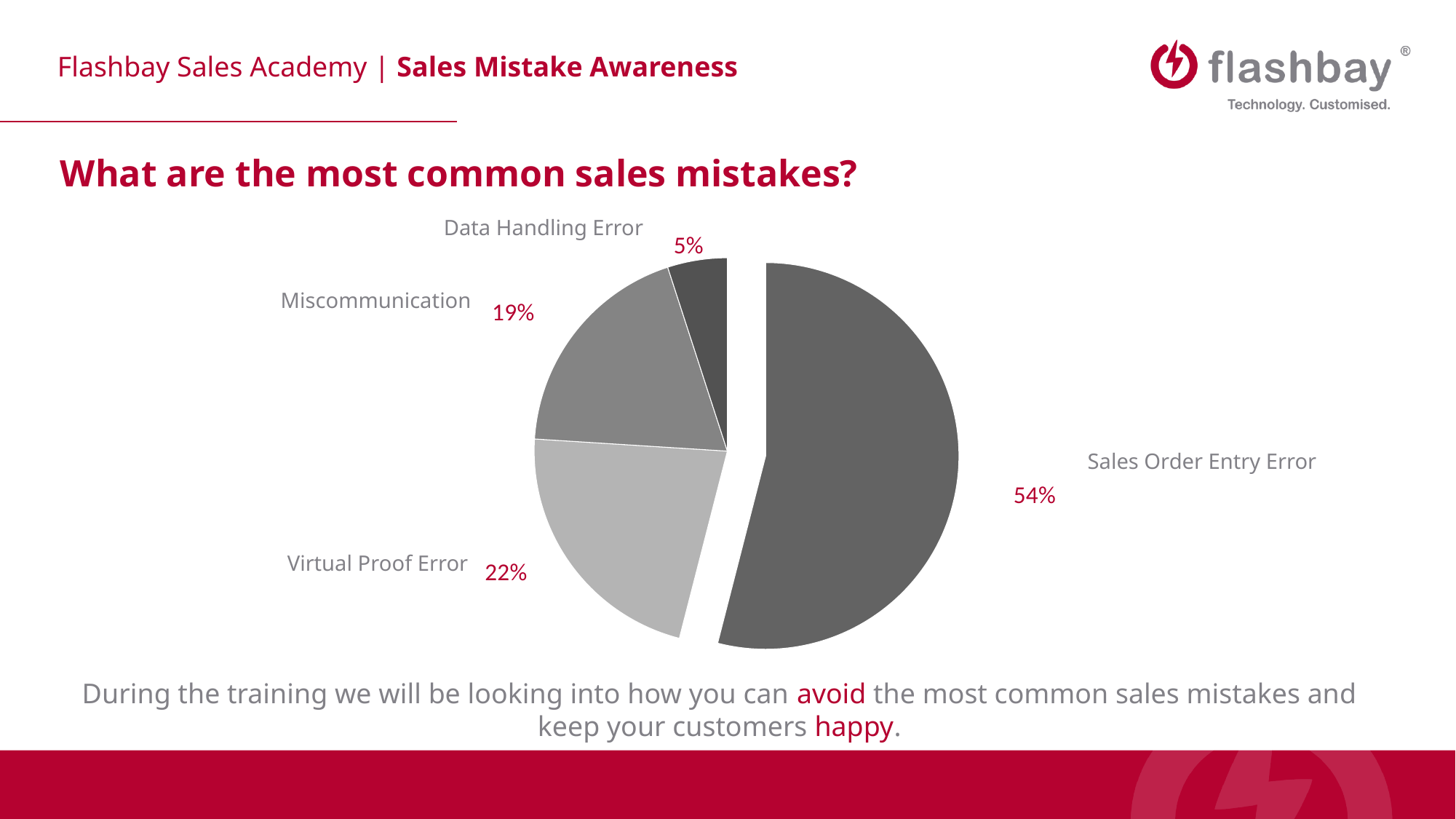
What is the difference in percentage points between Sales Order Entry Error and Virtual Proof Error? 32 What percentage is shown for Miscommunication? 19% Which slice of the pie is pulled out (exploded) from the rest? Sales Order Entry Error Which sales mistake category has the largest share of the pie? Sales Order Entry Error How many categories are shown in the pie chart? 4 Which sales mistake category has the smallest share of the pie? Data Handling Error What percentage is shown for Virtual Proof Error? 22% What share of the pie does Sales Order Entry Error account for? 54% What type of chart is shown on the slide? Pie chart Which has a larger share, Virtual Proof Error or Miscommunication? Virtual Proof Error What percentage is shown for Data Handling Error? 5% What is the difference in percentage points between Miscommunication and Data Handling Error? 14